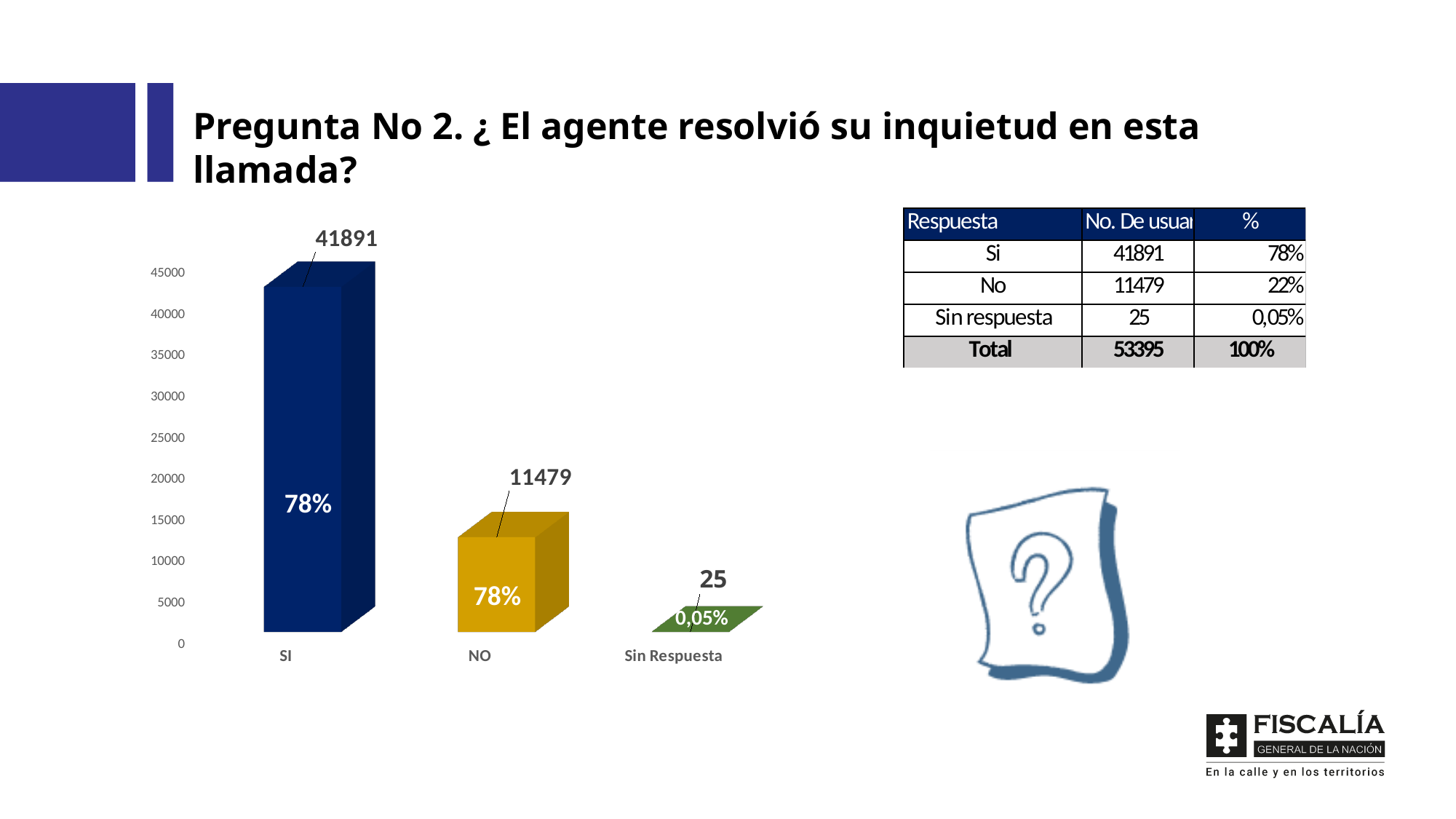
Is the value for SI greater or less than 40000? greater What value is shown for the SI bar? 41891 Which is larger, the value for NO or the value for Sin Respuesta? NO Is the value for NO greater or less than 15000? less What percentage label is printed inside the SI bar? 78% What value is shown for the NO bar? 11479 What value is shown for the Sin Respuesta bar? 25 How many categories are shown on the x axis of the chart? 3 What is the difference between the SI and NO values? 30412 Which category has the lowest value in the chart? Sin Respuesta What kind of chart is shown on the slide? bar chart Which category has the highest value in the chart? SI